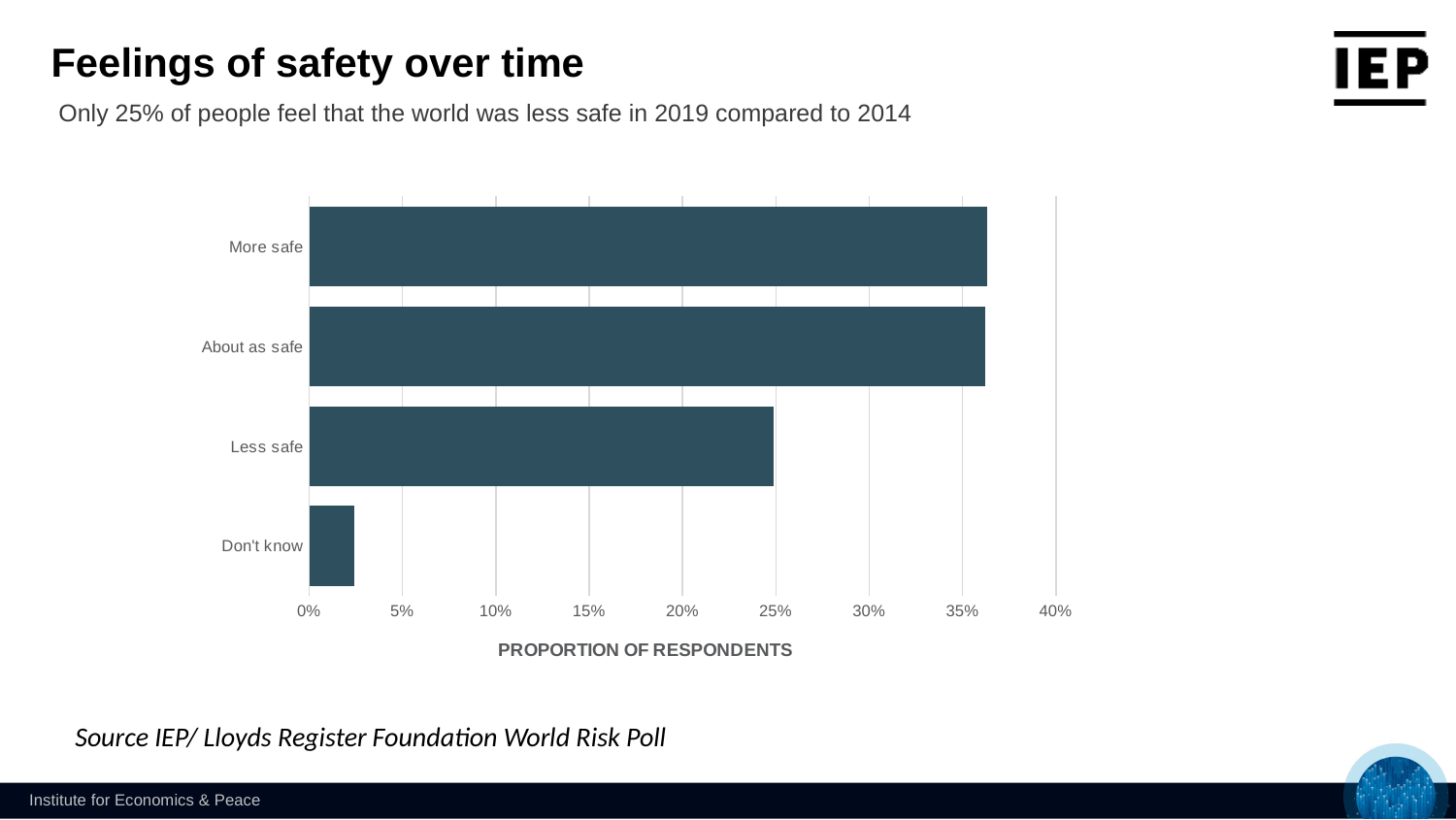
What is the title of the slide? Feelings of safety over time Which is larger, the value for Less safe or the value for Don't know? Less safe Is the value for Don't know greater or less than 5%? less Is the value for More safe greater or less than 35%? greater Which is larger, the value for More safe or the value for Less safe? More safe How many categories are shown in the chart? 4 What proportion of respondents said the world was less safe? 25% Is the value for Less safe greater or less than 30%? less Which category has the lowest proportion of respondents? Don't know What is the title of the chart's horizontal axis? PROPORTION OF RESPONDENTS What kind of chart is shown on the slide? bar chart